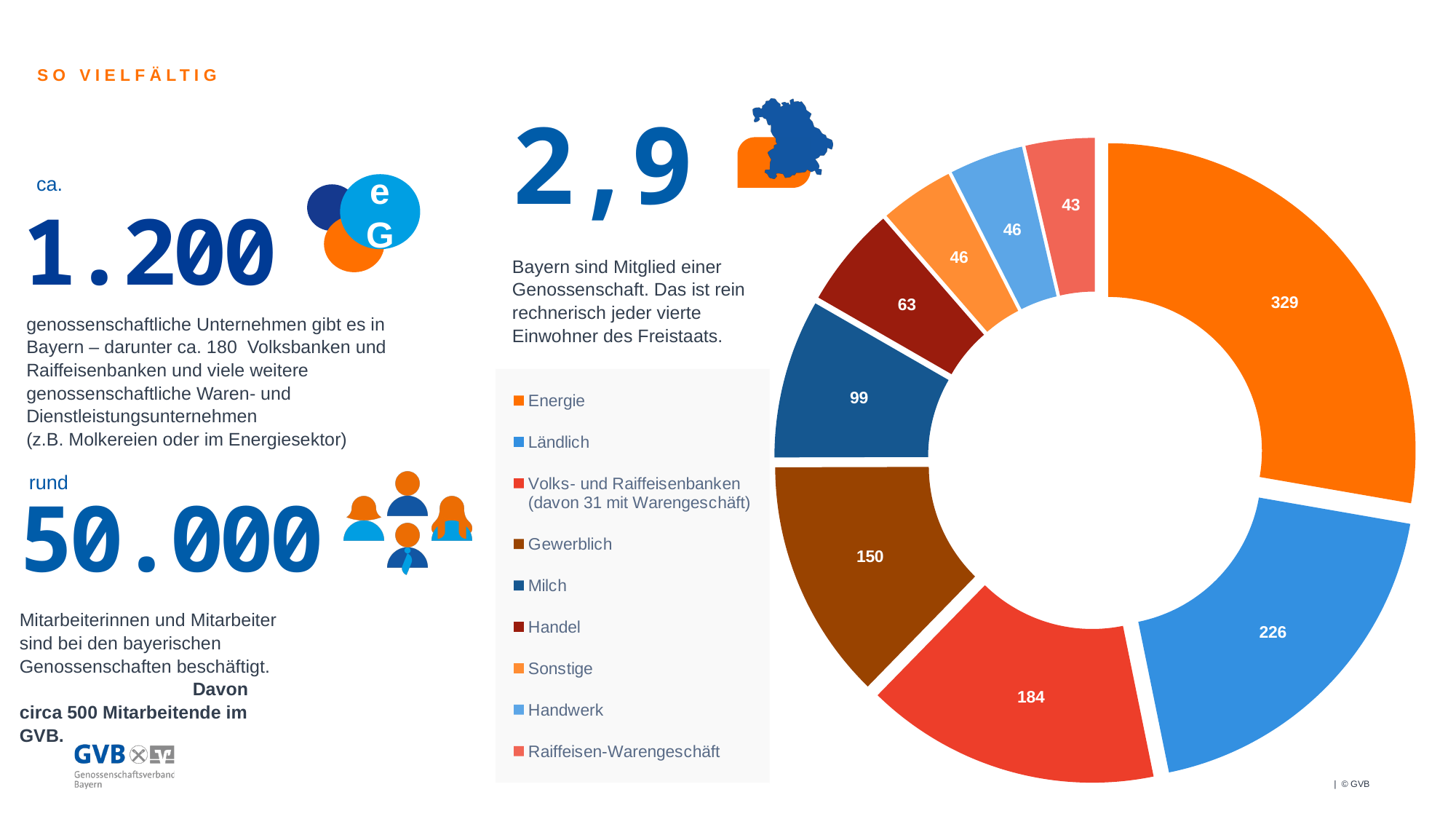
Which category has the smallest slice in the donut chart? Raiffeisen-Warengeschäft Which is larger, the value for Handel or the value for Milch? Milch What is the value for Gewerblich in the donut chart? 150 Which two categories in the donut chart both have the value 46? Sonstige and Handwerk What is the difference between the values for Energie and Ländlich? 103 How many categories does the donut chart show? 9 What type of chart is shown on the slide? Pie (donut) chart What is the value for Energie in the donut chart? 329 What is the value for Volks- und Raiffeisenbanken in the donut chart? 184 Which category has the largest slice in the donut chart? Energie What is the total of all values in the donut chart? 1186 What is the value for Milch in the donut chart? 99